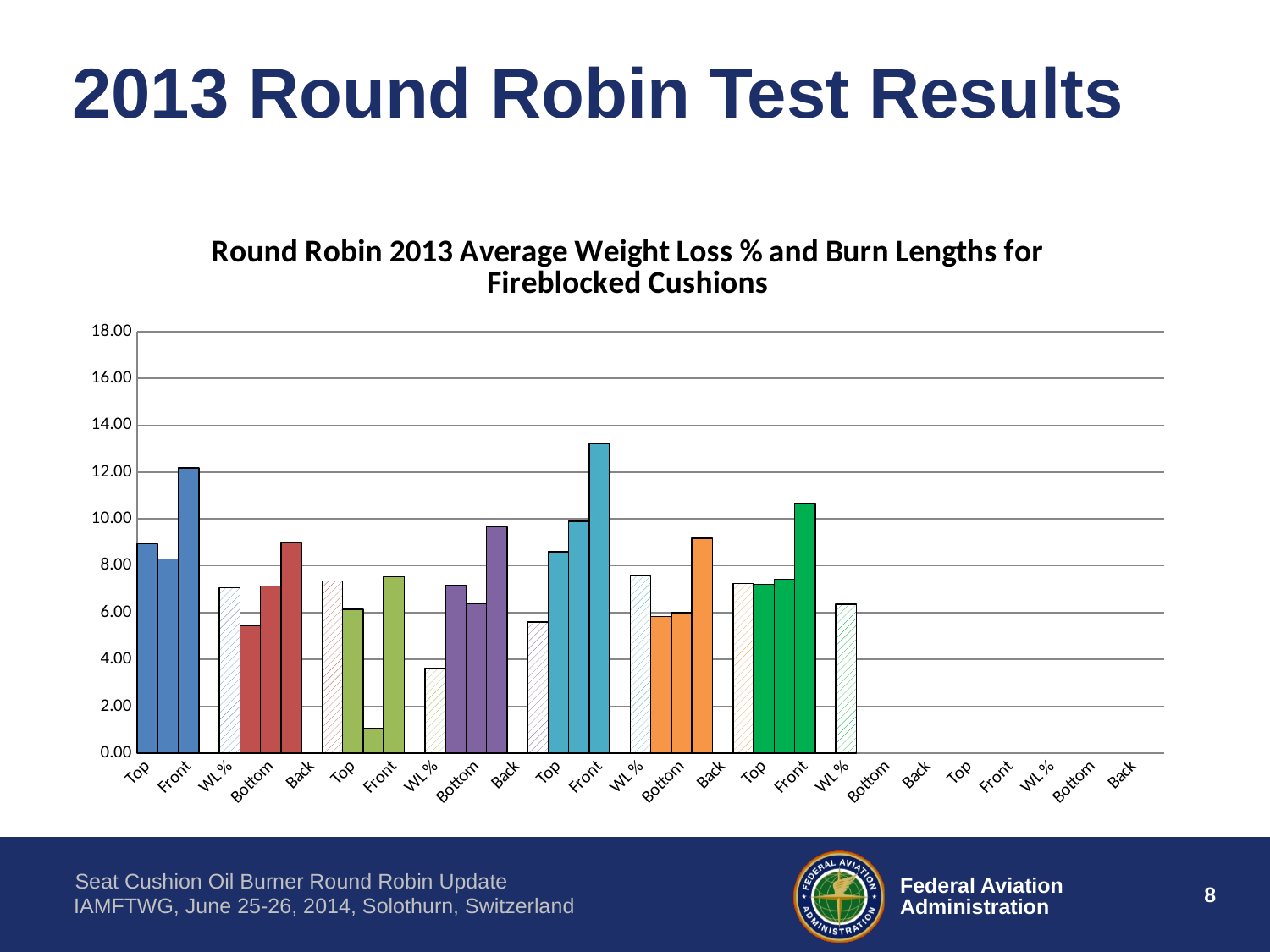
Which colour is the shortest bar in the chart? Green Which is taller, the tallest teal bar or the tallest orange bar? The tallest teal bar What kind of chart is shown on the slide? Bar chart What is the title of the chart? Round Robin 2013 Average Weight Loss % and Burn Lengths for Fireblocked Cushions Is the tallest dark blue bar greater or less than 10.00? greater Is the tallest bar in the chart greater or less than 12.00? greater Is the tallest orange bar greater or less than 8.00? greater Which colour is the tallest bar in the chart? Teal (light blue) How many times does the label "Back" appear on the x axis? 5 What is the highest value shown on the vertical axis of the chart? 18.00